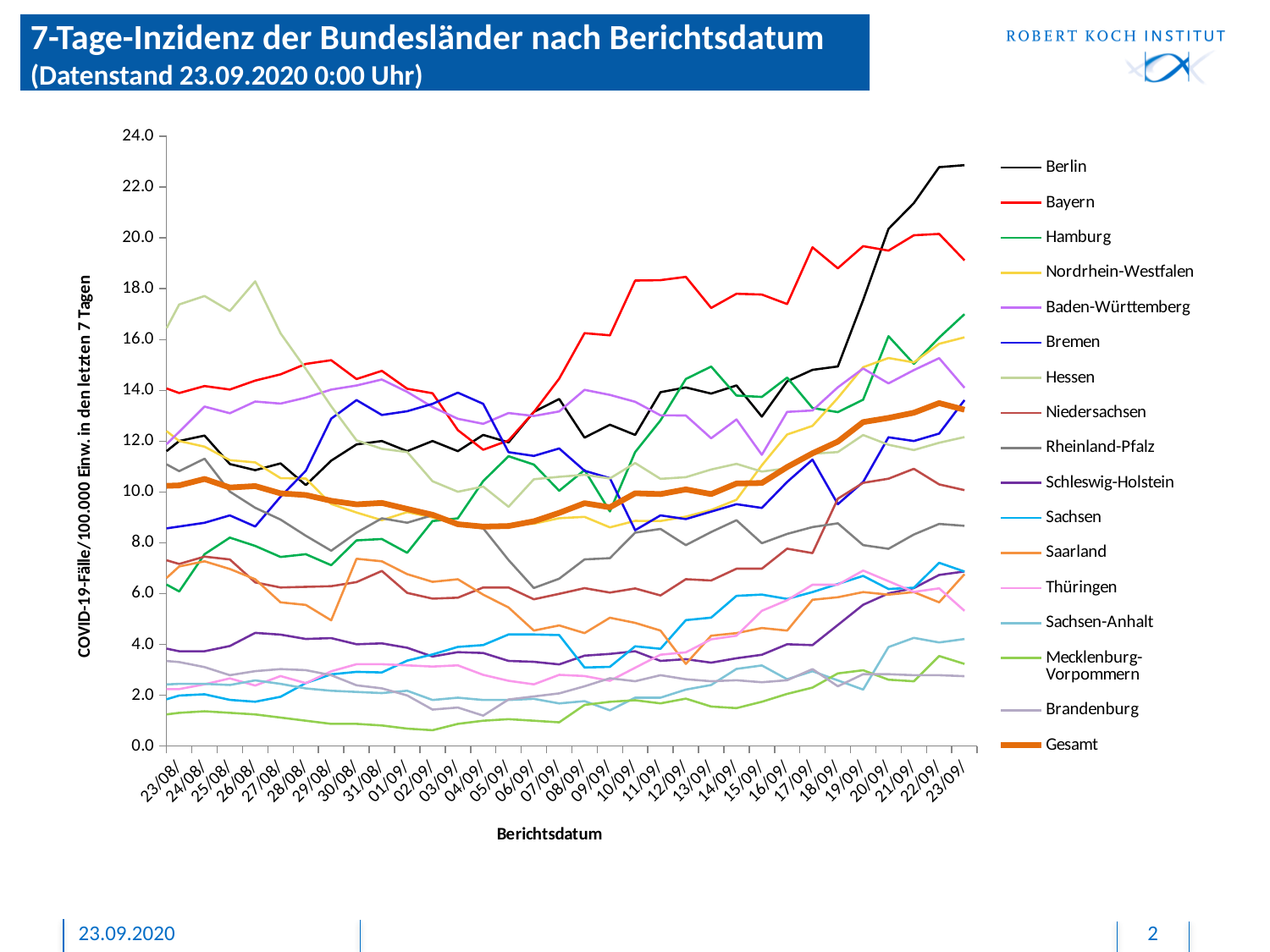
Is the value for Bayern on 23/09 greater or less than 20.0? less On 23/09, which is larger: the value for Berlin or the value for Bayern? Berlin How many dates are shown along the x axis? 32 Is the value for Berlin on 23/09 greater or less than 20.0? greater What kind of chart is shown on the slide? Line chart Which series has the highest value on 23/09? Berlin Which series has the highest value on 23/08? Hessen Does the Gesamt line rise or fall between 05/09 and 23/09? Rise Which series has the lowest value on 23/08? Mecklenburg-Vorpommern What is the label of the y axis? COVID-19-Fälle/100.000 Einw. in den letzten 7 Tagen Is the value for Gesamt on 23/09 greater or less than 12.0? greater How many series does the legend list? 17